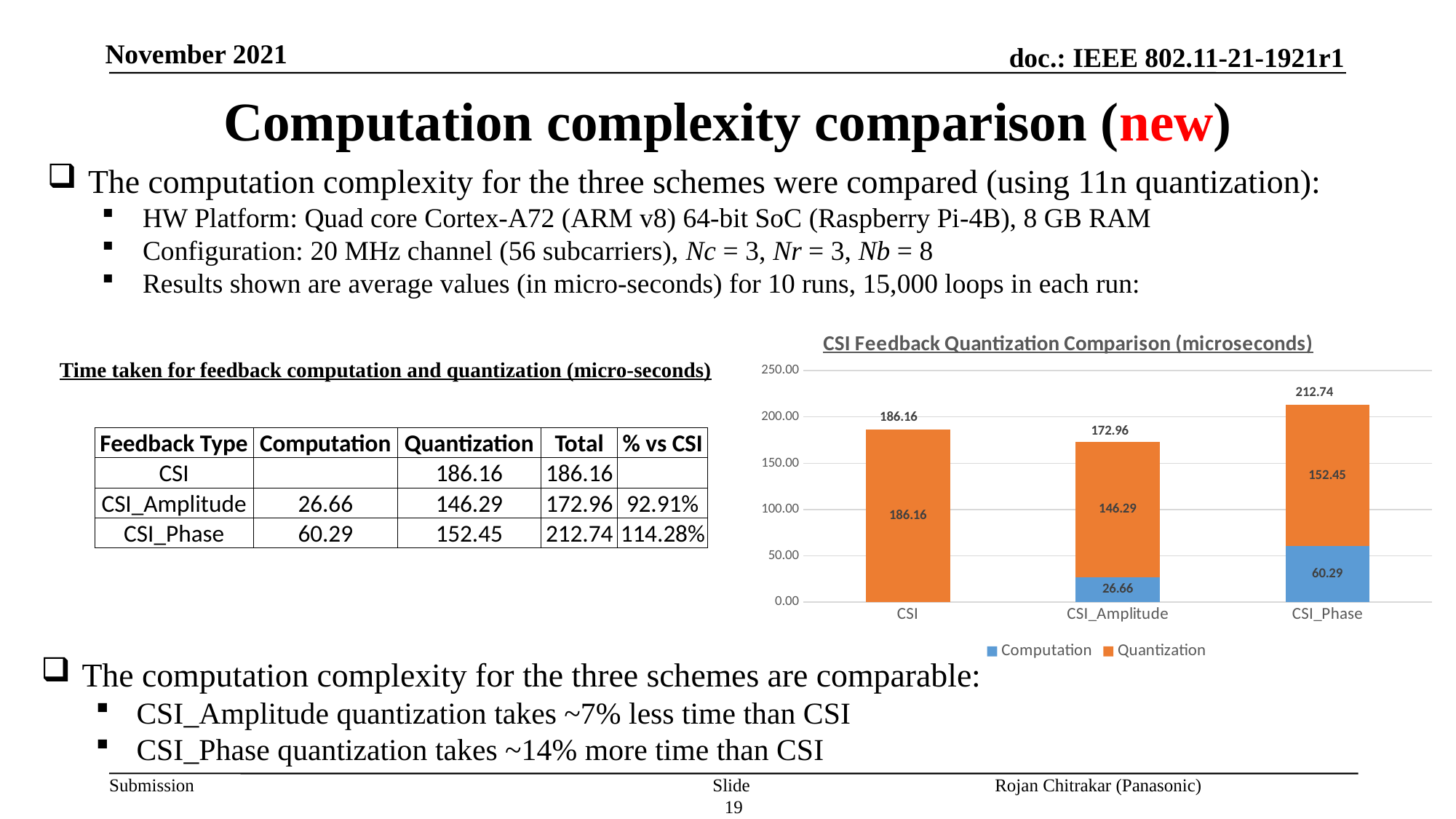
What is the Computation value for CSI_Phase in the chart? 60.29 What is the difference between the Quantization values for CSI and CSI_Amplitude? 39.87 What is the title of the chart? CSI Feedback Quantization Comparison (microseconds) What is the Quantization value for CSI_Amplitude in the chart? 146.29 How many categories are shown on the x axis of the chart? 3 Is the total for CSI_Phase greater or less than 200.00? greater Which category has the lowest total bar in the chart? CSI_Amplitude What is the Computation value for CSI_Amplitude in the chart? 26.66 How many series does the chart legend list? 2 What type of chart is shown on the slide? Stacked bar chart Which category has the highest total bar in the chart? CSI_Phase What is the total of the stacked bar for CSI_Phase? 212.74